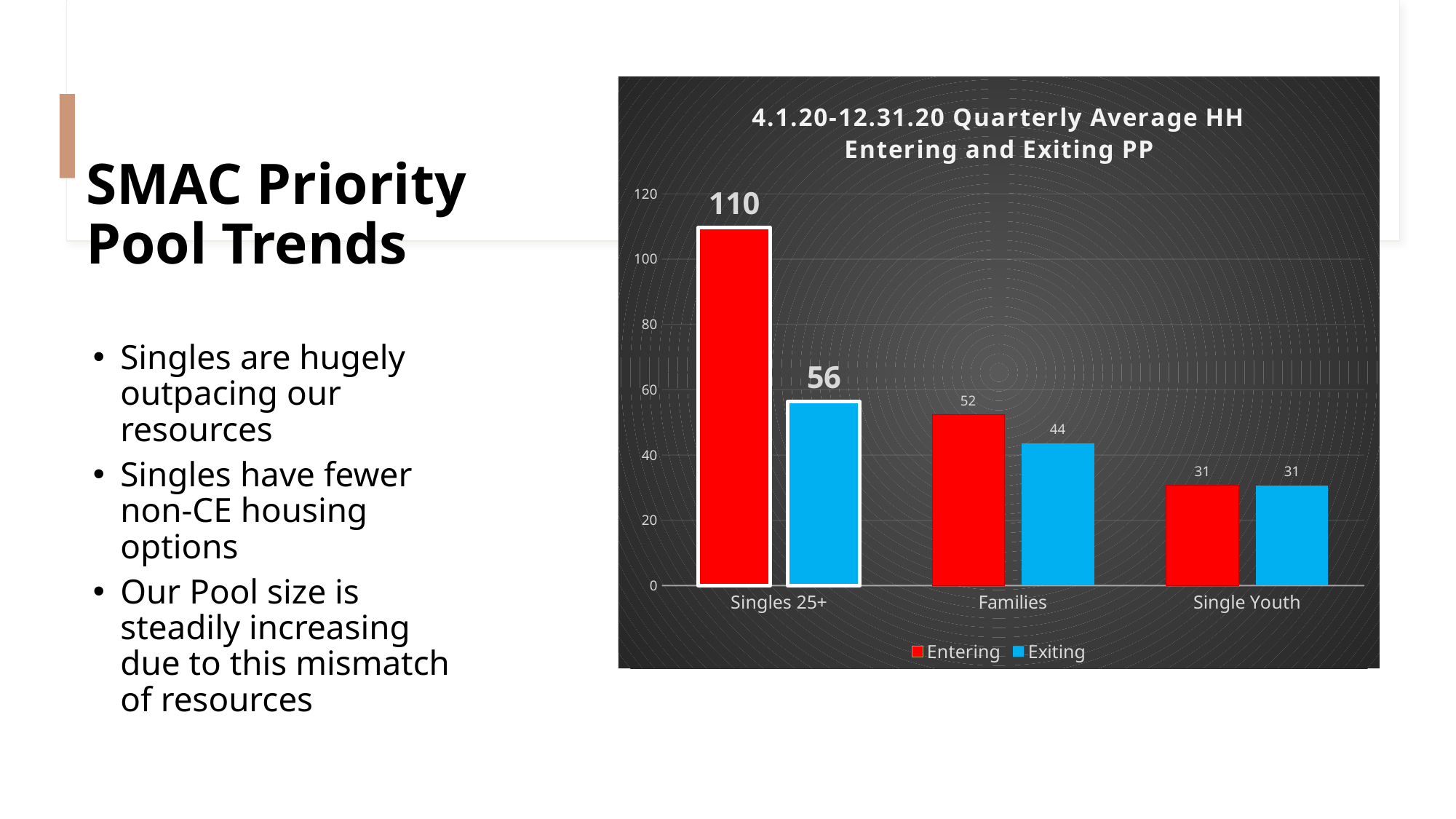
How many series does the legend list? 2 Which is larger for Families, the Entering value or the Exiting value? Entering Which category has the highest Entering value? Singles 25+ What kind of chart is shown on the slide? Bar chart Which category has the lowest Exiting value? Single Youth What is the title of the chart? 4.1.20-12.31.20 Quarterly Average HH Entering and Exiting PP What is the Entering value for Single Youth? 31 What is the Entering value for Singles 25+? 110 What is the difference between the Entering values for Families and Single Youth? 21 What is the Exiting value for Families? 44 How many categories are shown on the x axis? 3 What is the difference between the Entering and Exiting values for Singles 25+? 54